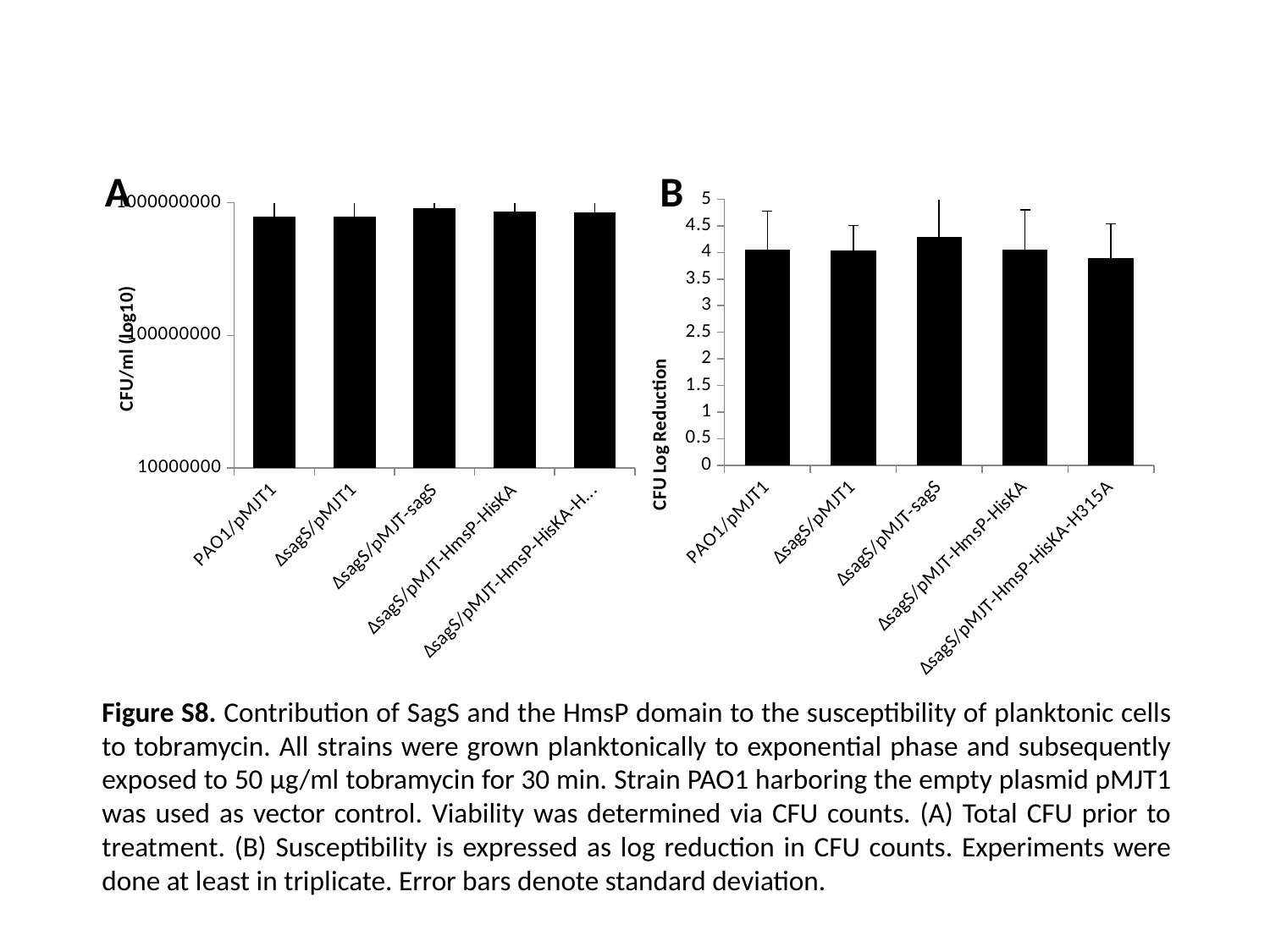
In chart B (CFU Log Reduction), is the value for ΔsagS/pMJT-sagS greater or less than 4? greater In chart B (CFU Log Reduction), which strain has the highest log reduction? ΔsagS/pMJT-sagS In chart B (CFU Log Reduction), how many strains are plotted? 5 What kind of chart is chart A (CFU/ml (Log10))? bar chart In chart B (CFU Log Reduction), is the value for ΔsagS/pMJT-HmsP-HisKA-H315A greater or less than 4? less In chart A (CFU/ml (Log10)), is the value for PAO1/pMJT1 greater or less than 100000000? greater What is the y-axis label of chart B? CFU Log Reduction In chart B (CFU Log Reduction), which is larger, the value for ΔsagS/pMJT-sagS or the value for ΔsagS/pMJT-HmsP-HisKA-H315A? ΔsagS/pMJT-sagS What kind of chart is chart B (CFU Log Reduction)? bar chart In chart A (CFU/ml (Log10)), how many strains are plotted? 5 What is the y-axis label of chart A? CFU/ml (Log10)